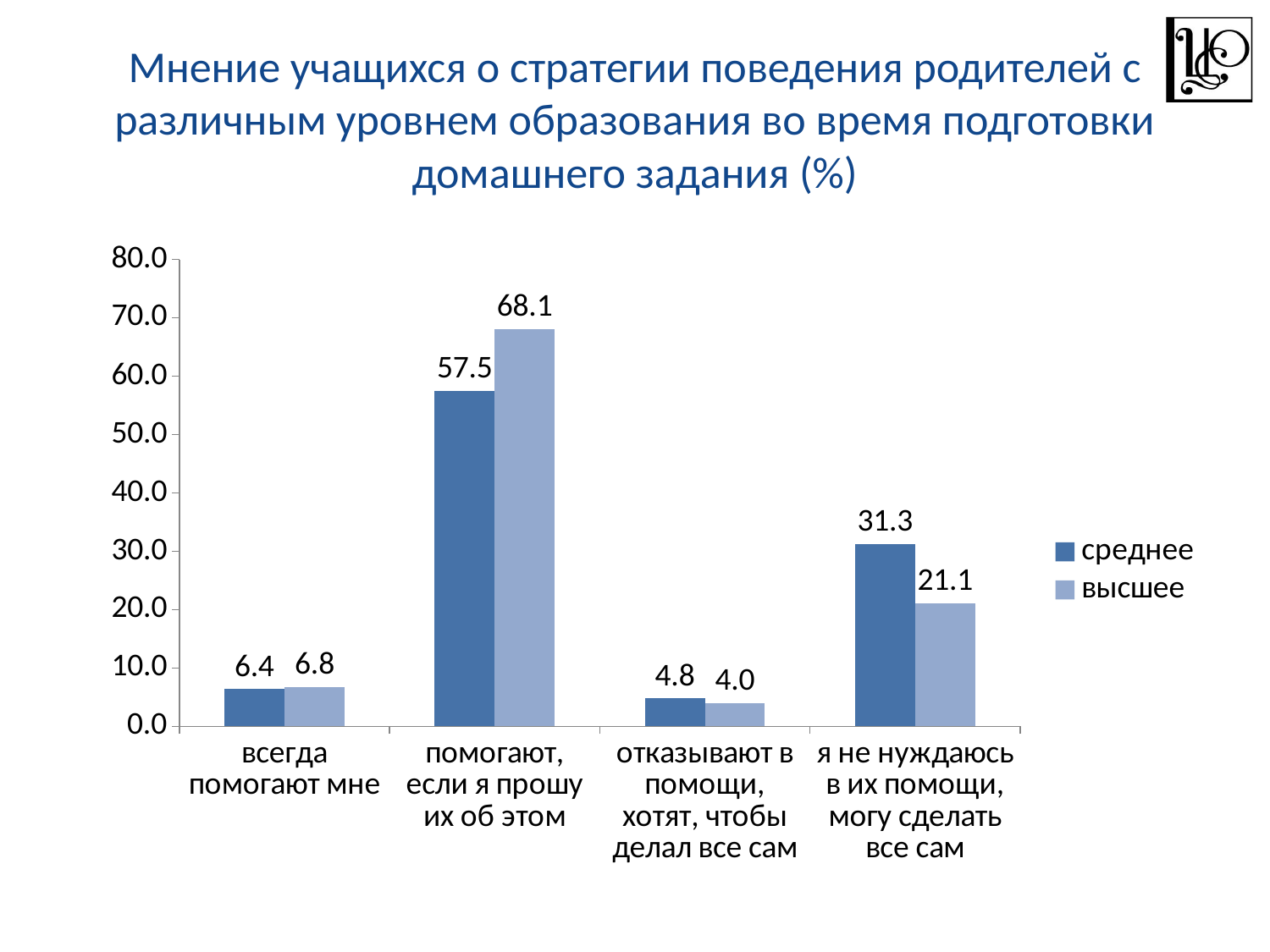
How many series does the legend list? 2 What is the value for "высшее" in the category "всегда помогают мне"? 6.8 How many categories are shown on the x axis? 4 Which category has the highest value for the "высшее" series? помогают, если я прошу их об этом What is the value for "высшее" in the category "я не нуждаюсь в их помощи, могу сделать все сам"? 21.1 Is the value for "среднее" in the category "я не нуждаюсь в их помощи, могу сделать все сам" greater or less than 30.0? greater What is the difference between the "высшее" and "среднее" values in the category "помогают, если я прошу их об этом"? 10.6 In the category "я не нуждаюсь в их помощи, могу сделать все сам", which series has the larger value, "среднее" or "высшее"? среднее What is the value for "среднее" in the category "помогают, если я прошу их об этом"? 57.5 What are the two series named in the legend? среднее, высшее Which category has the lowest value for the "среднее" series? отказывают в помощи, хотят, чтобы делал все сам What kind of chart is shown on the slide? bar chart